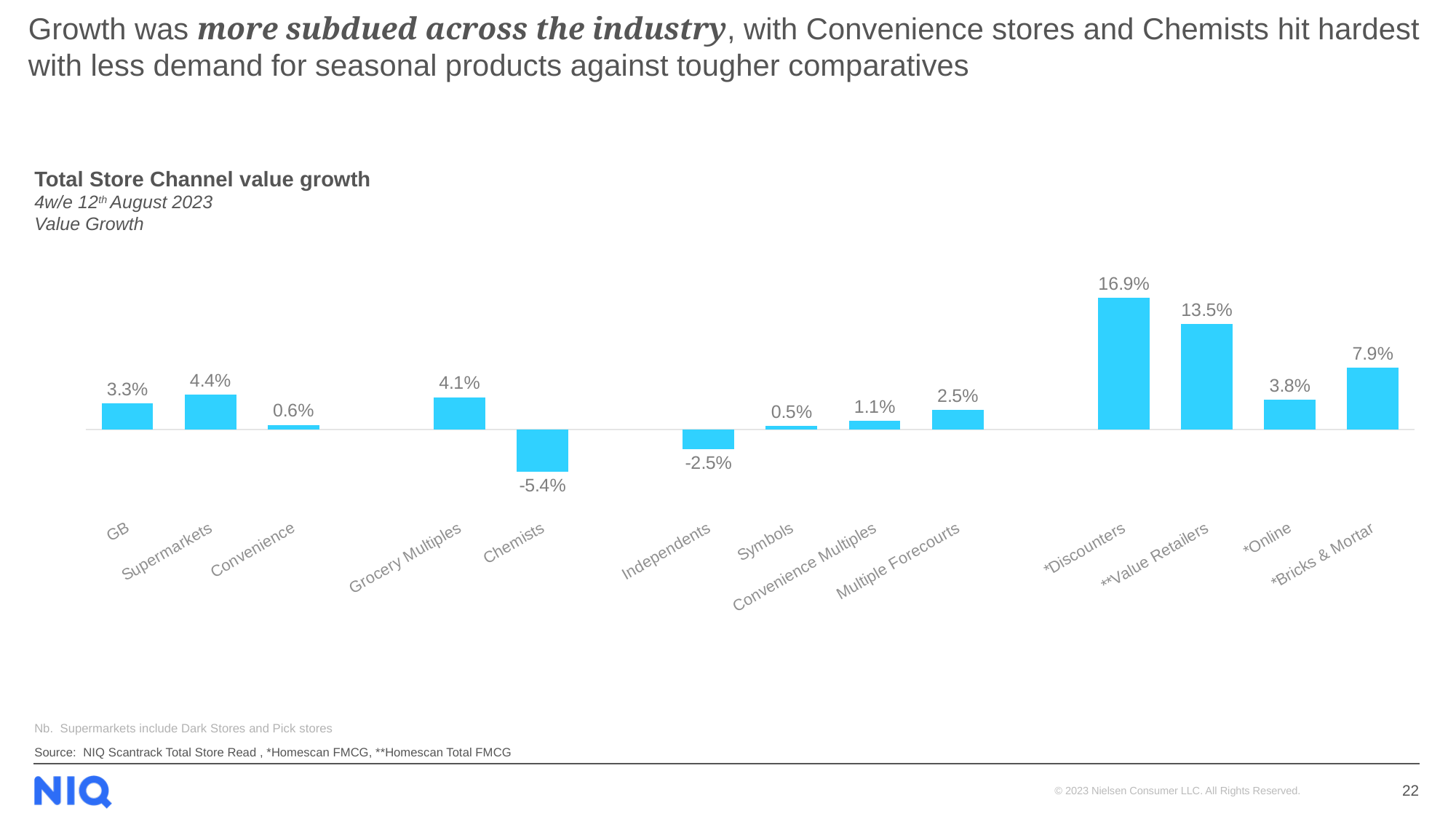
What is the value growth for Multiple Forecourts? 2.5% What is the value growth for *Discounters? 16.9% How many channels are shown in the chart? 13 Which channel has the lowest value growth? Chemists What is the value growth for Chemists? -5.4% What is the value growth for Supermarkets? 4.4% Which channel has the highest value growth? *Discounters What is the difference between the value growth of *Discounters and **Value Retailers? 3.4% Which has higher value growth, Independents or Symbols? Symbols Which has higher value growth, *Online or *Bricks & Mortar? *Bricks & Mortar What is the difference between the value growth of Supermarkets and Convenience? 3.8% What type of chart is used to show Total Store Channel value growth? Bar chart